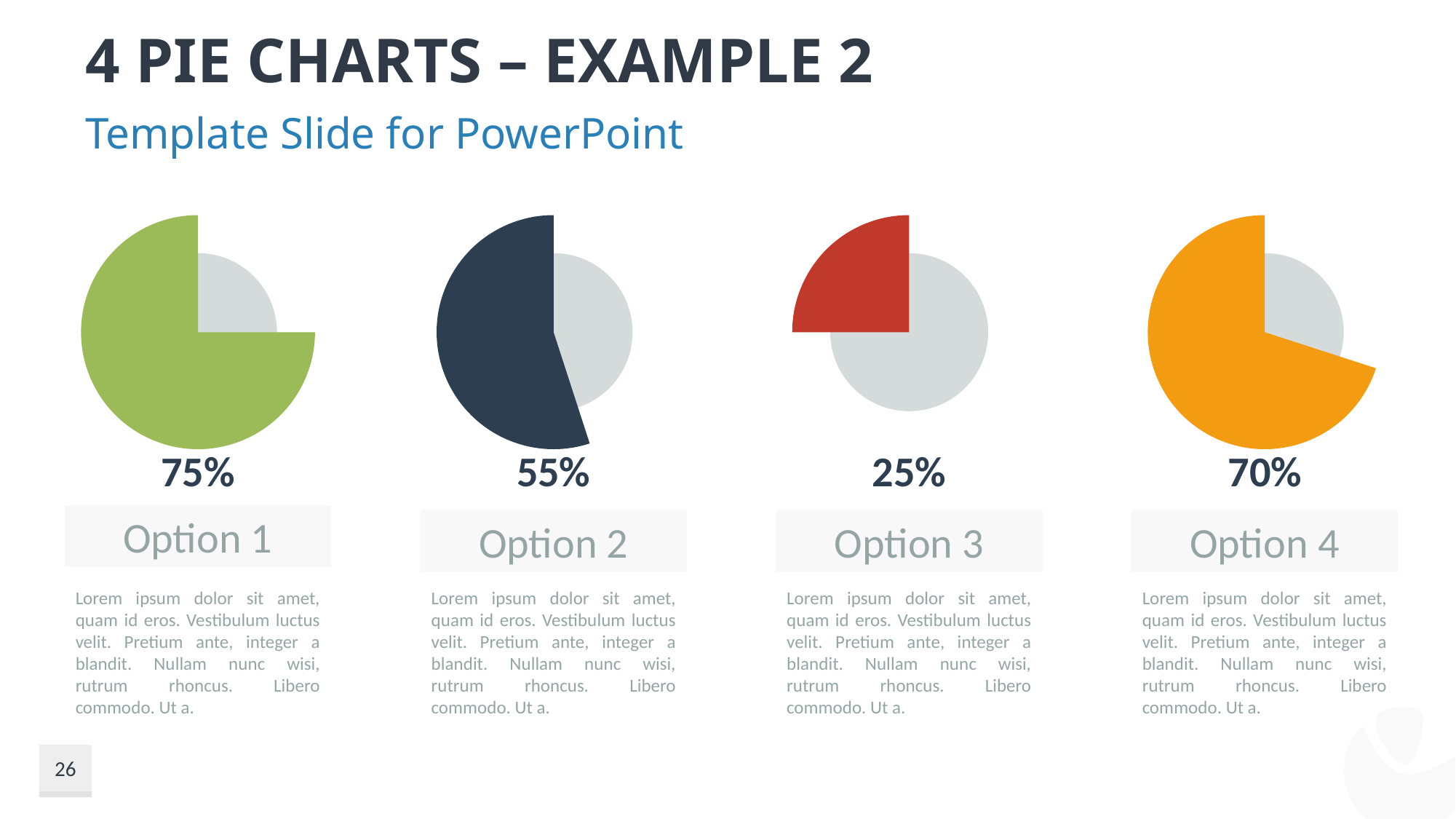
Which option has the lowest percentage? Option 3 What is the difference between the percentages for Option 1 and Option 3? 50% What percentage is shown for Option 3? 25% What percentage is shown for Option 4? 70% What colour is the filled slice of the Option 3 pie chart? Red Which option has the highest percentage? Option 1 What is the difference between the percentages for Option 4 and Option 2? 15% What percentage is shown for Option 2? 55% What kind of chart is used for each option on the slide? Pie chart How many pie charts are shown on the slide? 4 Which is larger, the percentage for Option 2 or Option 4? Option 4 What percentage is shown for Option 1? 75%